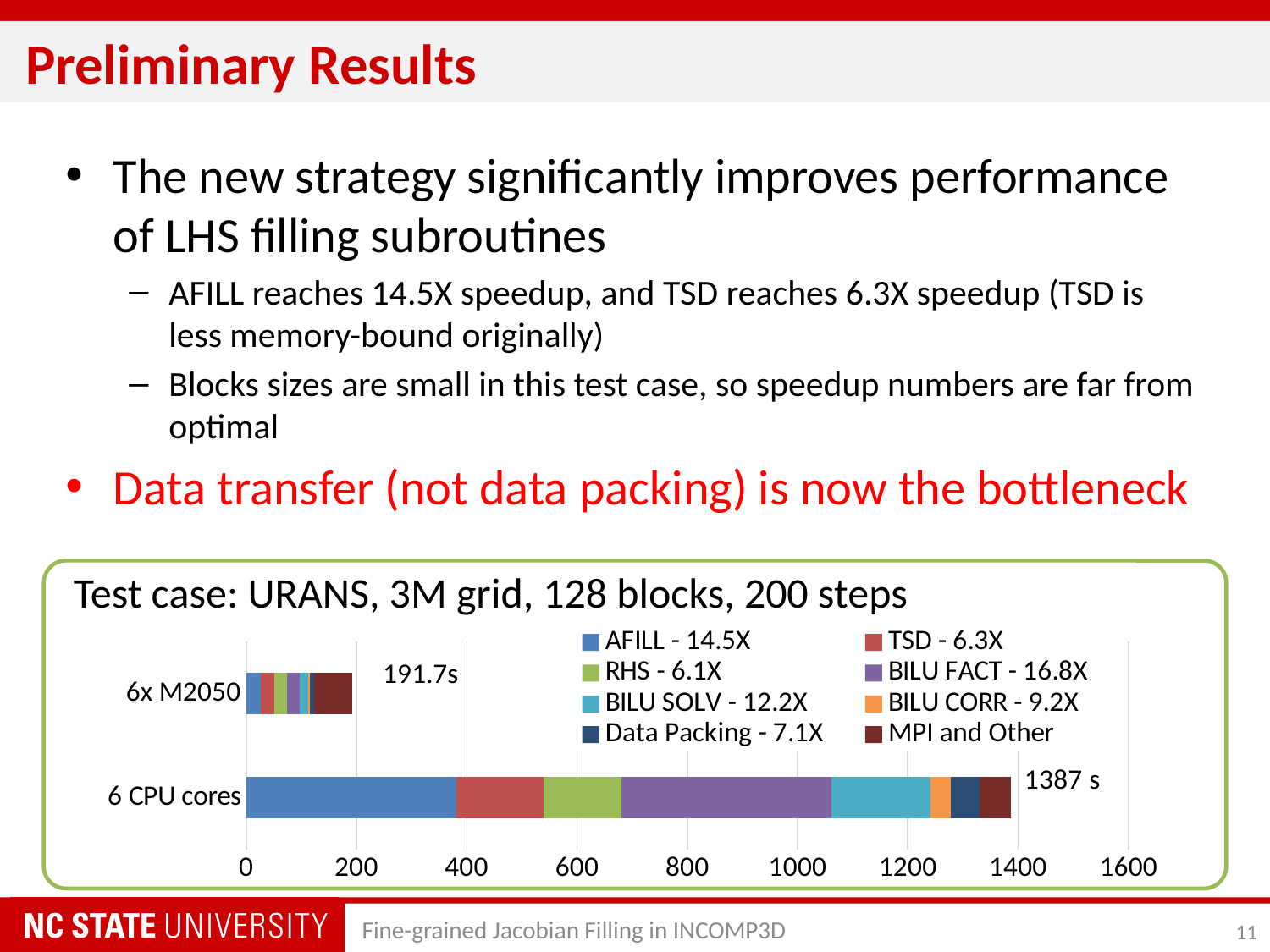
Which bar has the largest total? 6 CPU cores Which configuration has the longer total time, 6 CPU cores or 6x M2050? 6 CPU cores Is the total for 6x M2050 greater or less than 200? less Is the total for 6 CPU cores greater or less than 1200? greater What is the total time shown for the 6 CPU cores bar? 1387 s How many series does the legend list? 8 What kind of chart is shown on the slide? Stacked bar chart Which bar has the smallest total? 6x M2050 What speedup is listed in the legend for AFILL? 14.5X How many bars (configurations) are plotted in the chart? 2 What is the difference between the total for 6 CPU cores and the total for 6x M2050? 1195.3 s What is the total time shown for the 6x M2050 bar? 191.7s